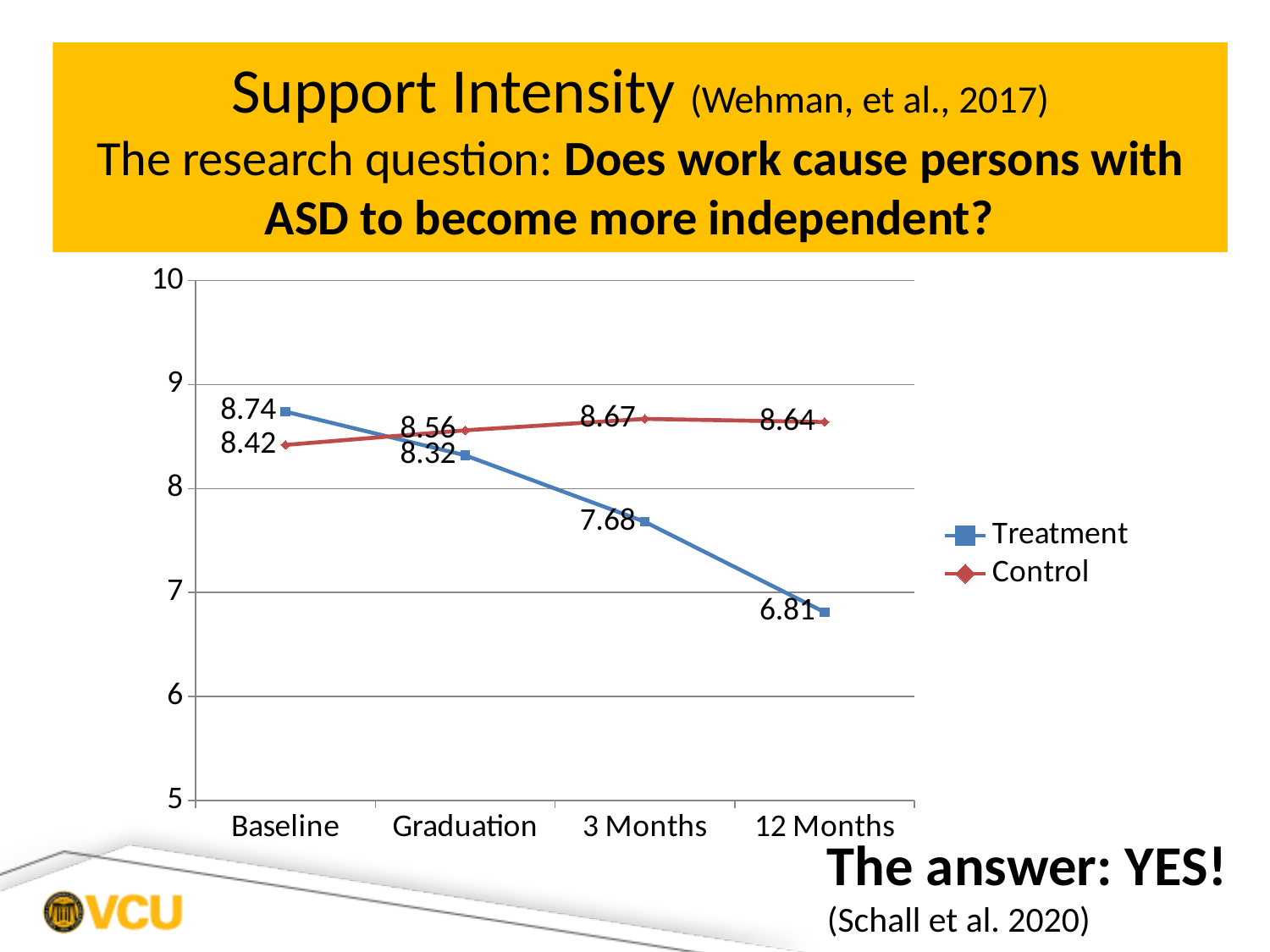
How many series does the legend list? 2 What is the Treatment value at Baseline? 8.74 Which series has the larger value at Baseline, Treatment or Control? Treatment What is the Treatment value at 3 Months? 7.68 What is the Control value at Graduation? 8.56 What is the Control value at 12 Months? 8.64 At which time point is the Control value highest? 3 Months Does the Treatment series rise or fall from Baseline to 12 Months? fall How many time points are shown on the x axis? 4 What is the difference between the Control and Treatment values at 12 Months? 1.83 Is the Treatment value at 12 Months greater or less than 7? less At which time point is the Treatment value lowest? 12 Months